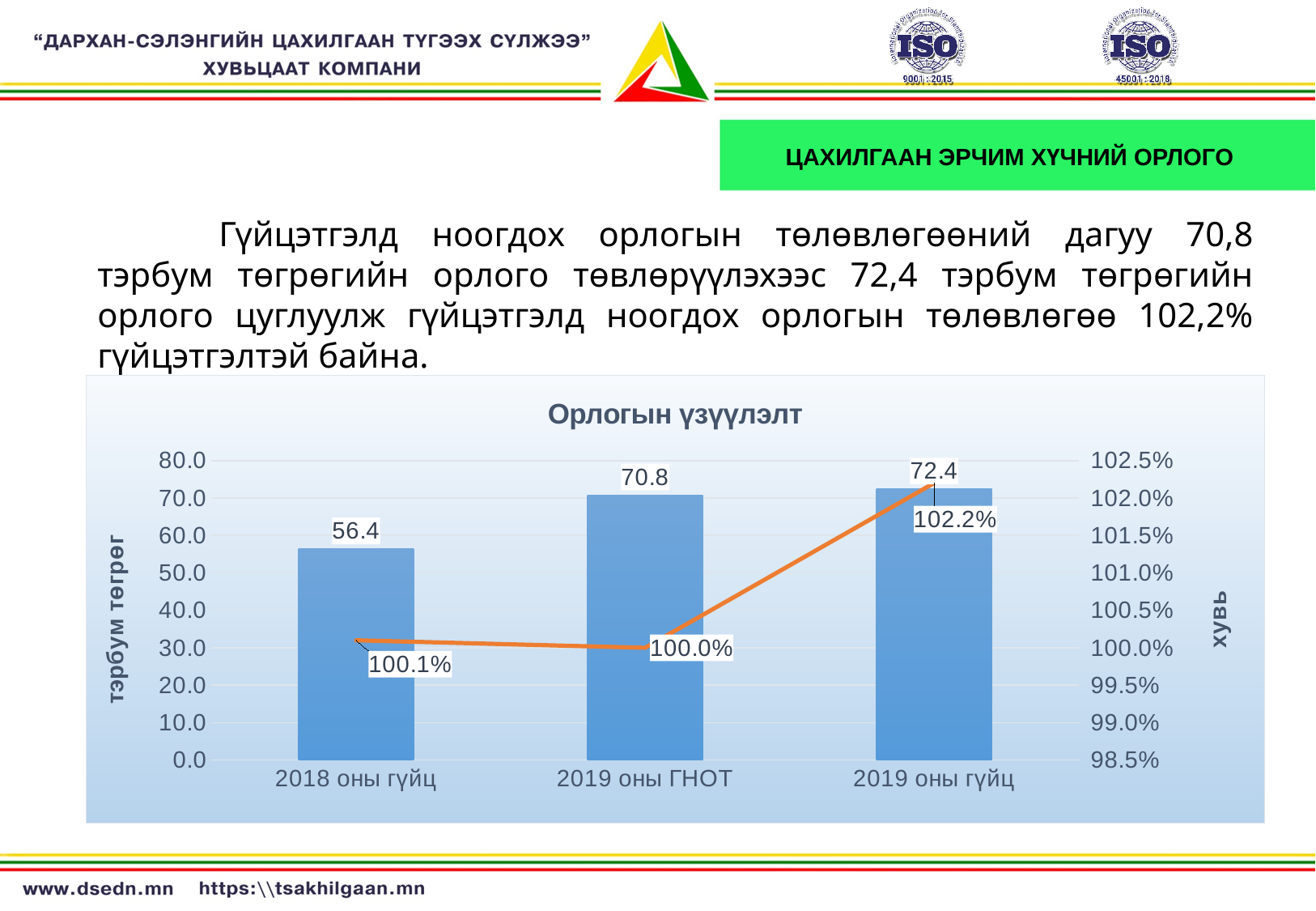
What is the difference between the bar values for 2019 оны ГНОТ and 2018 оны гүйц? 14.4 Which is larger, the bar value for 2018 оны гүйц or for 2019 оны ГНОТ? 2019 оны ГНОТ Which category has the lowest bar value? 2018 оны гүйц What is the difference between the bar values for 2019 оны гүйц and 2019 оны ГНОТ? 1.6 What is the title of the chart? Орлогын үзүүлэлт What percentage does the line show for 2019 оны гүйц? 102.2% Which category has the highest bar value? 2019 оны гүйц What percentage does the line show for 2018 оны гүйц? 100.1% How many categories are shown on the x axis? 3 What is the bar value for 2019 оны ГНОТ? 70.8 What is the bar value for 2018 оны гүйц? 56.4 What is the bar value for 2019 оны гүйц? 72.4